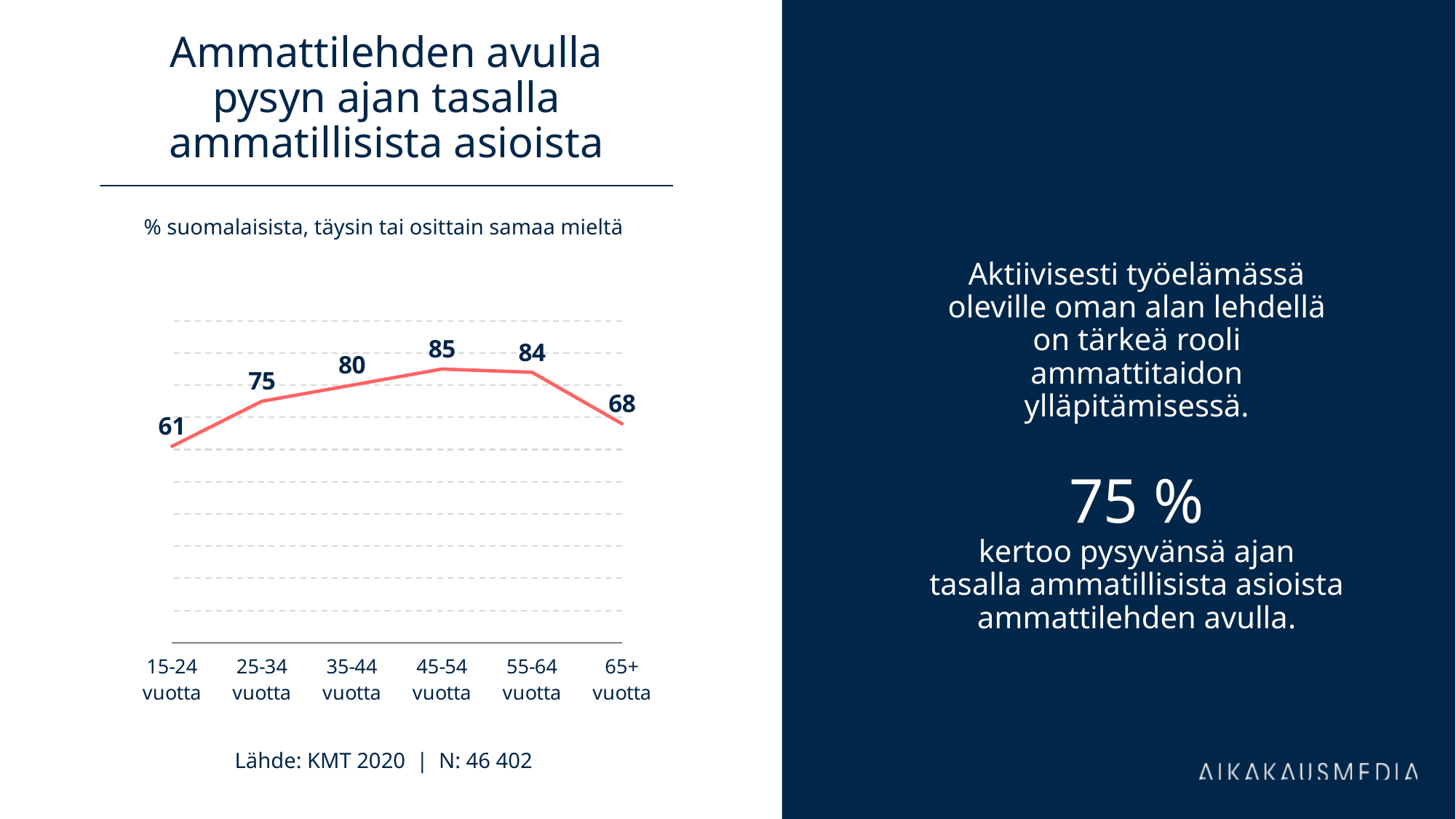
What is the value for the 45-54 vuotta age group? 85 What is the value for the 65+ vuotta age group? 68 Which age group has the lowest value? 15-24 vuotta Do the values rise or fall from 15-24 vuotta to 45-54 vuotta? Rise What is the difference between the values for 55-64 vuotta and 65+ vuotta? 16 What is the value for the 15-24 vuotta age group? 61 What is the difference between the values for 45-54 vuotta and 15-24 vuotta? 24 What is the source cited below the chart? KMT 2020 Which age group has the highest value? 45-54 vuotta How many age groups are plotted on the chart? 6 Which is larger, the value for 25-34 vuotta or the value for 65+ vuotta? 25-34 vuotta (75) What kind of chart is shown on the slide? Line chart